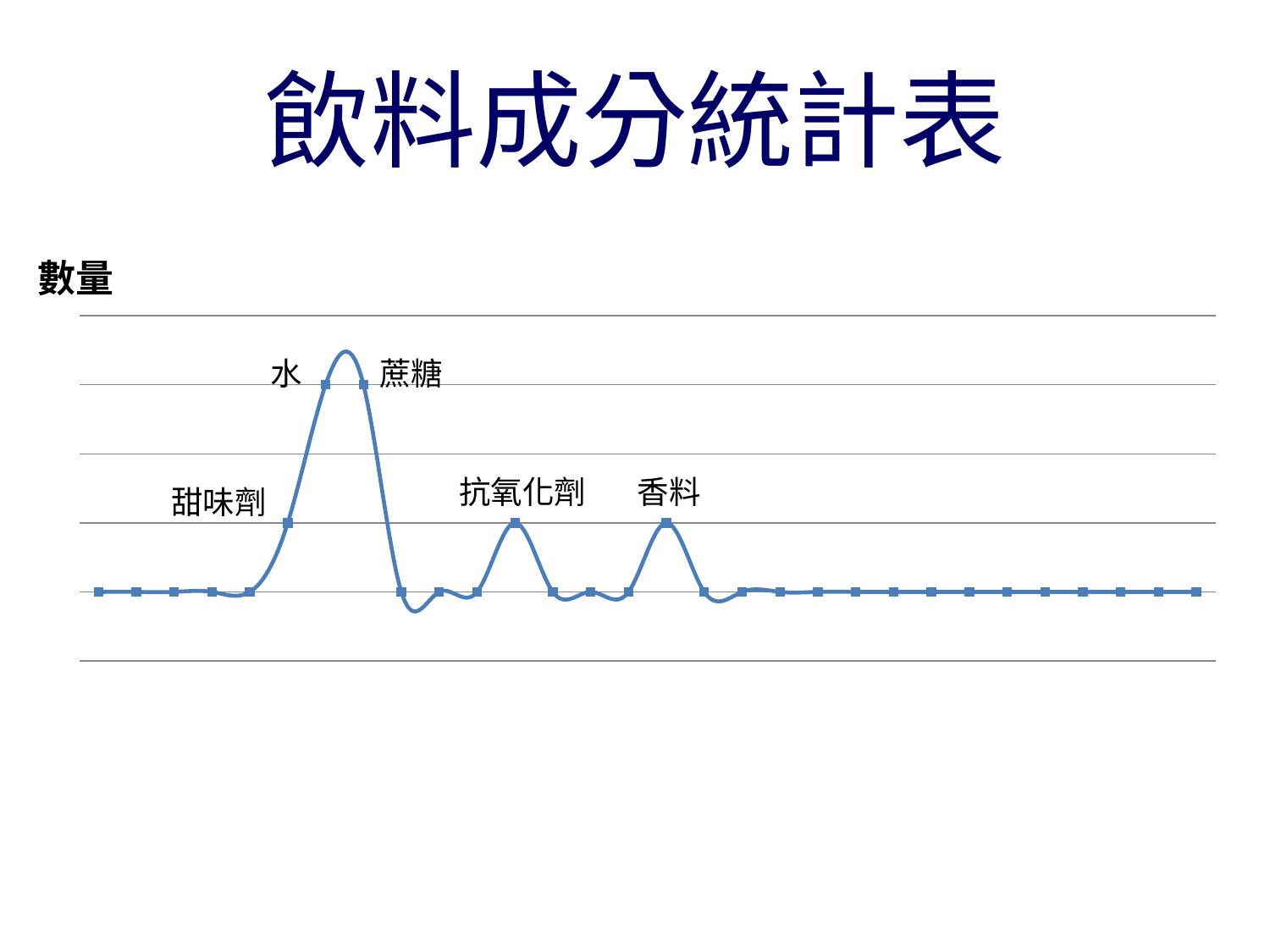
Which has a higher peak on the chart, 香料 or 蔗糖? 蔗糖 What is the title of the chart on the slide? 數量 Which has a higher peak on the chart, 蔗糖 or 抗氧化劑? 蔗糖 Which has a lower value on the chart, 甜味劑 or 水? 甜味劑 How many ingredient labels are marked on the line chart? 5 What kind of chart is shown on the slide? line chart After the 香料 peak, does the line rise, fall, or stay flat toward the right end of the chart? stay flat